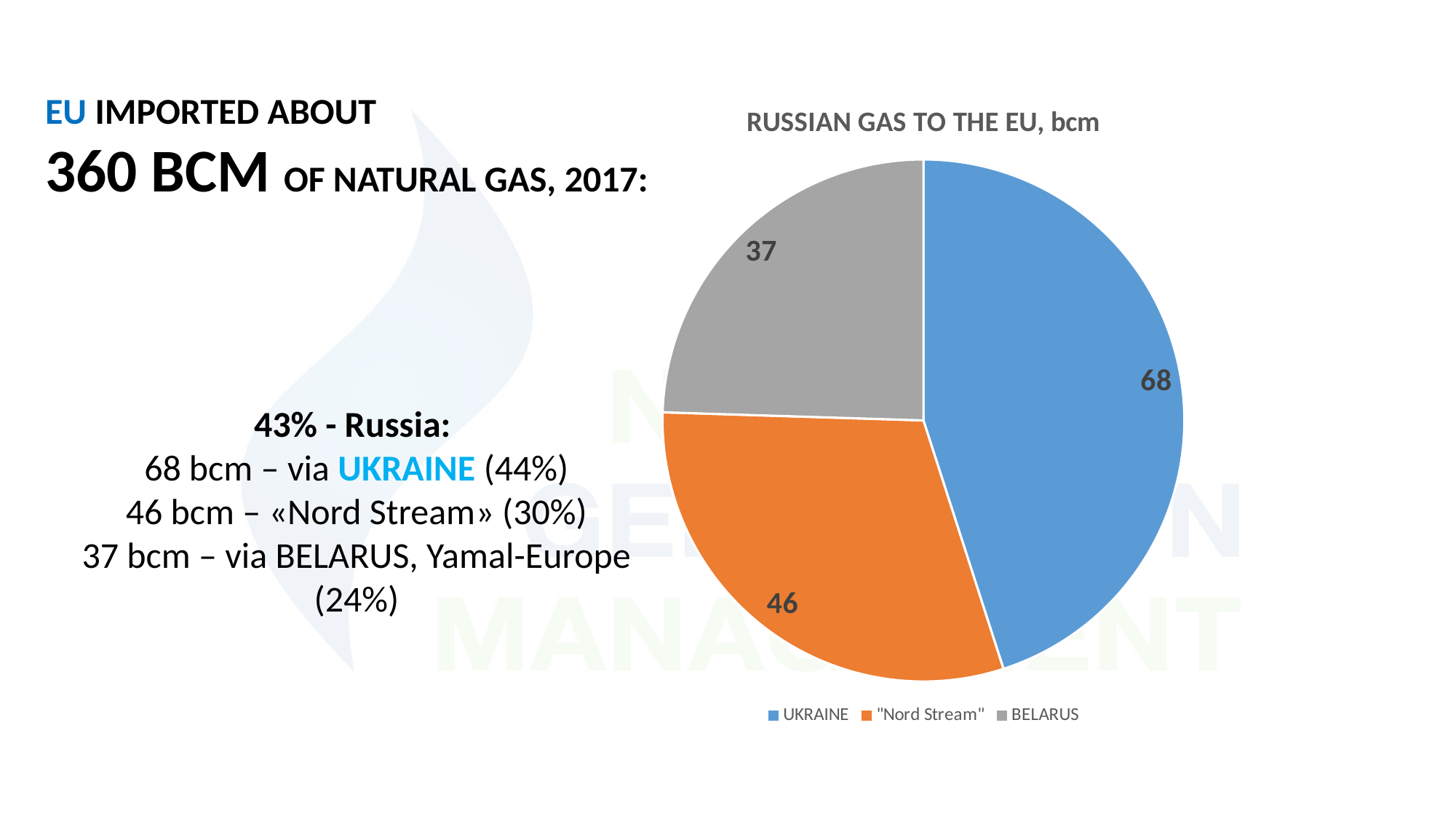
What type of chart is shown on the slide? Pie chart What is the value for UKRAINE in the pie chart? 68 Which is larger, the value for "Nord Stream" or the value for BELARUS? "Nord Stream" Which category has the largest slice of the pie? UKRAINE What is the title of the chart? RUSSIAN GAS TO THE EU, bcm What is the difference between the UKRAINE and "Nord Stream" values? 22 How many slices does the pie chart have? 3 What is the difference between the UKRAINE and BELARUS values? 31 What is the value for "Nord Stream" in the pie chart? 46 What colour is the BELARUS slice? Grey What is the value for BELARUS in the pie chart? 37 Which category has the smallest slice of the pie? BELARUS